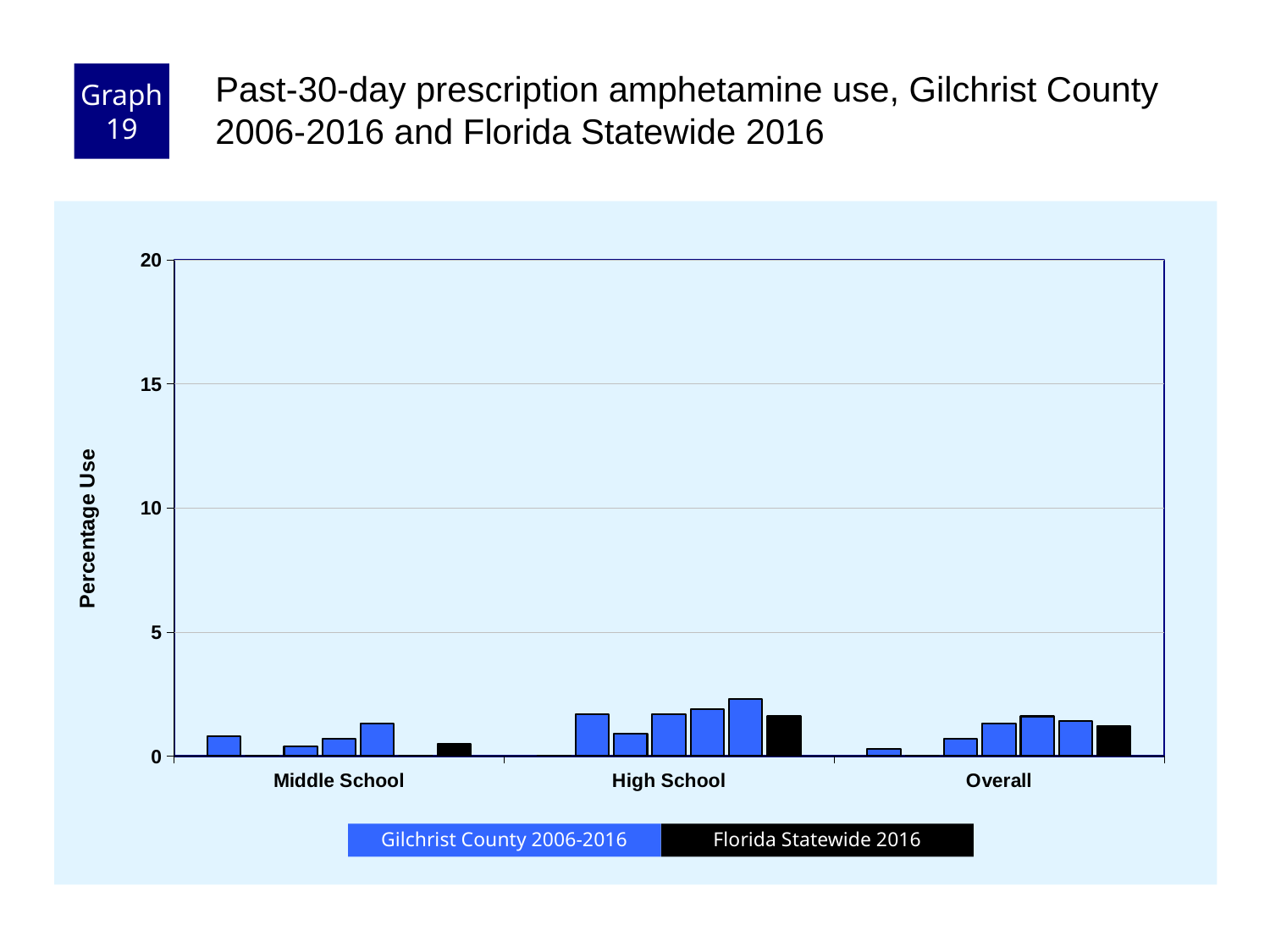
What is the label on the y axis? Percentage Use Is the Florida Statewide 2016 value for High School larger or smaller than the Florida Statewide 2016 value for Middle School? larger Is the Florida Statewide 2016 value for High School greater or less than 5? less Which category has the lowest bars overall? Middle School Which series is shown in black in the legend? Florida Statewide 2016 Are all the plotted values greater or less than 10? less Which category has the highest bars overall? High School How many categories are shown on the x axis? 3 What kind of chart is shown on the slide? bar chart How many series does the legend list? 2 Is the Florida Statewide 2016 value for Middle School greater or less than 5? less